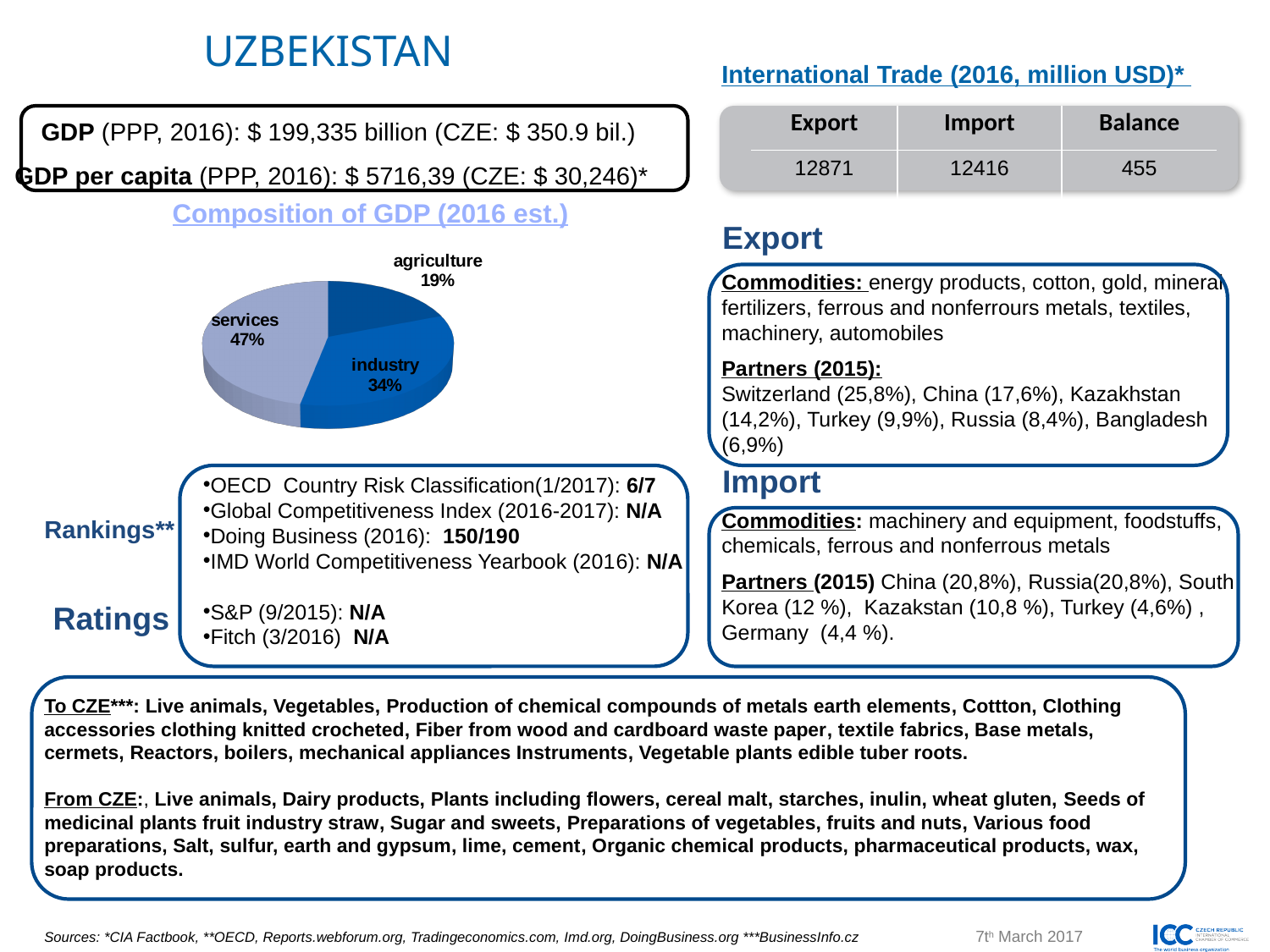
What is the difference in percentage points between the industry and agriculture shares in the Composition of GDP pie chart? 15% What share of GDP does services account for in the Composition of GDP pie chart? 47% What share of GDP does agriculture account for in the Composition of GDP pie chart? 19% What is the title of the chart on the slide? Composition of GDP (2016 est.) What type of chart is used to show the Composition of GDP? pie chart Which sector has the smallest share in the Composition of GDP pie chart? agriculture Which sector has the largest share in the Composition of GDP pie chart? services What share of GDP does industry account for in the Composition of GDP pie chart? 34% What is the difference in percentage points between the services and industry shares in the Composition of GDP pie chart? 13% What is the combined share of industry and agriculture in the Composition of GDP pie chart? 53% Which is larger in the Composition of GDP pie chart, the industry share or the agriculture share? industry How many sectors are shown in the Composition of GDP pie chart? 3